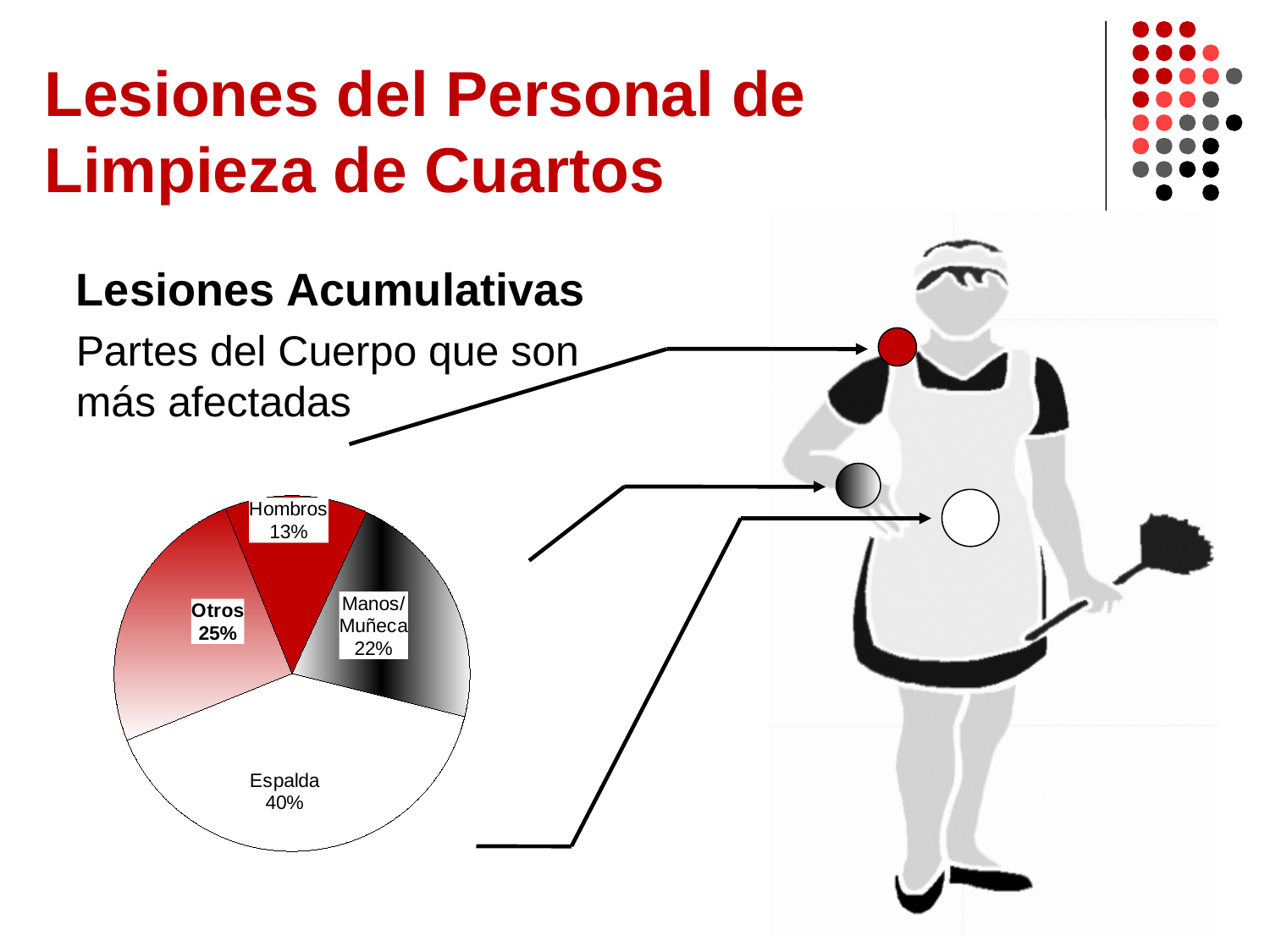
What kind of chart is shown on the slide? pie chart Which slice of the pie is shown in solid red? Hombros What is the difference in percentage points between Espalda and Hombros? 27 What is the difference in percentage points between Otros and Manos/Muñeca? 3 What percentage does the Manos/Muñeca slice represent? 22% How many slices does the pie chart have? 4 Which is larger, the Otros slice or the Manos/Muñeca slice? Otros What percentage does the Espalda slice represent? 40% Which body part has the smallest share of the pie? Hombros What percentage does the Otros slice represent? 25% Which body part has the largest share of the pie? Espalda What percentage does the Hombros slice represent? 13%